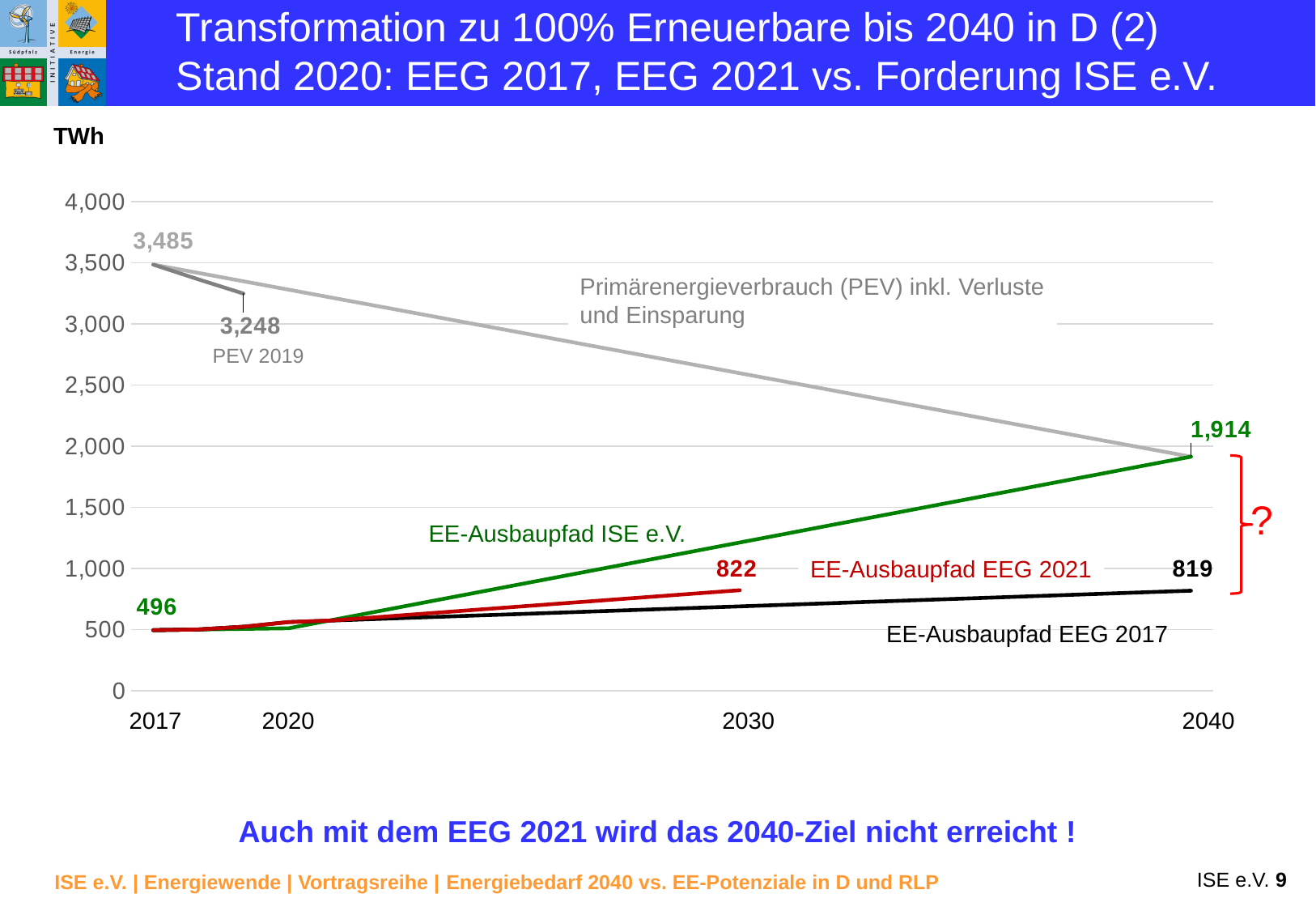
What value does the EE-Ausbaupfad EEG 2017 reach in 2040? 819 What is the difference between the 2040 value of the EE-Ausbaupfad ISE e.V. and the 2040 value of the EE-Ausbaupfad EEG 2017? 1,095 What unit is shown for the y-axis of the chart? TWh Does the Primärenergieverbrauch (PEV) line rise or fall from 2017 to 2040? fall What value does the EE-Ausbaupfad ISE e.V. reach in 2040? 1,914 What value does the EE-Ausbaupfad EEG 2021 reach in 2030? 822 What is the PEV 2019 value shown on the chart? 3,248 What is the starting value of the EE-Ausbaupfad lines in 2017? 496 Is the value of the EE-Ausbaupfad ISE e.V. in 2030 greater or less than 1,000? greater What is the Primärenergieverbrauch (PEV) value in 2017? 3,485 What is the difference between the PEV value in 2017 and the PEV 2019 value? 237 What kind of chart is shown on the slide? line chart